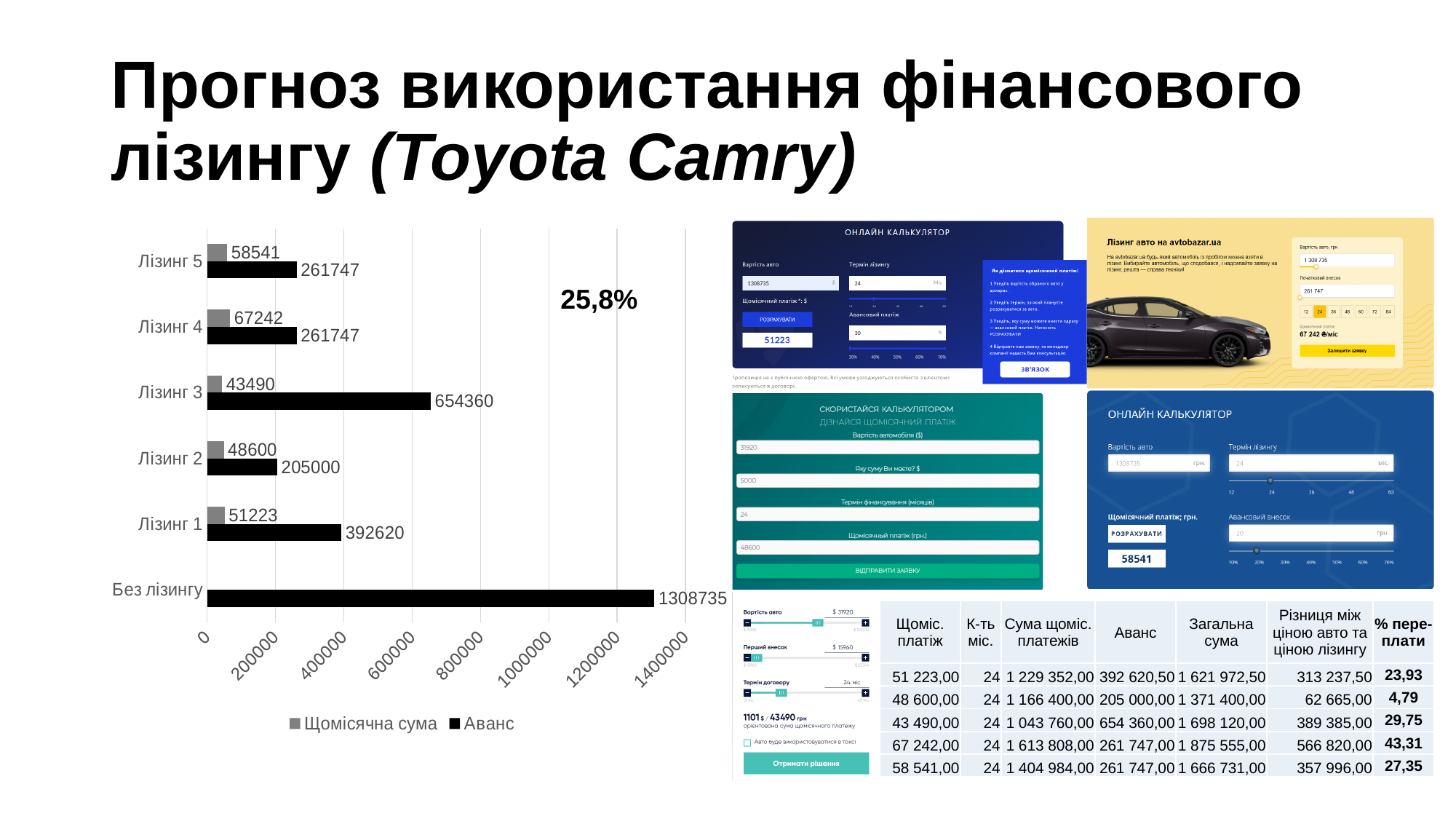
Which is larger, the Щомісячна сума for Лізинг 5 or for Лізинг 3? Лізинг 5 How many series does the legend list? 2 What kind of chart is shown on the slide? bar chart Which category has the lowest Аванс value? Лізинг 2 Which category has the highest Щомісячна сума value? Лізинг 4 What is the difference between the Аванс values for Лізинг 1 and Лізинг 2? 187620 What percentage is printed in bold next to the chart? 25,8% How many categories are shown on the chart? 6 What is the Щомісячна сума value for Лізинг 4? 67242 What is the Аванс value for Лізинг 3? 654360 Is the Аванс value for Лізинг 3 greater or less than 600000? greater What is the Аванс value for Без лізингу? 1308735